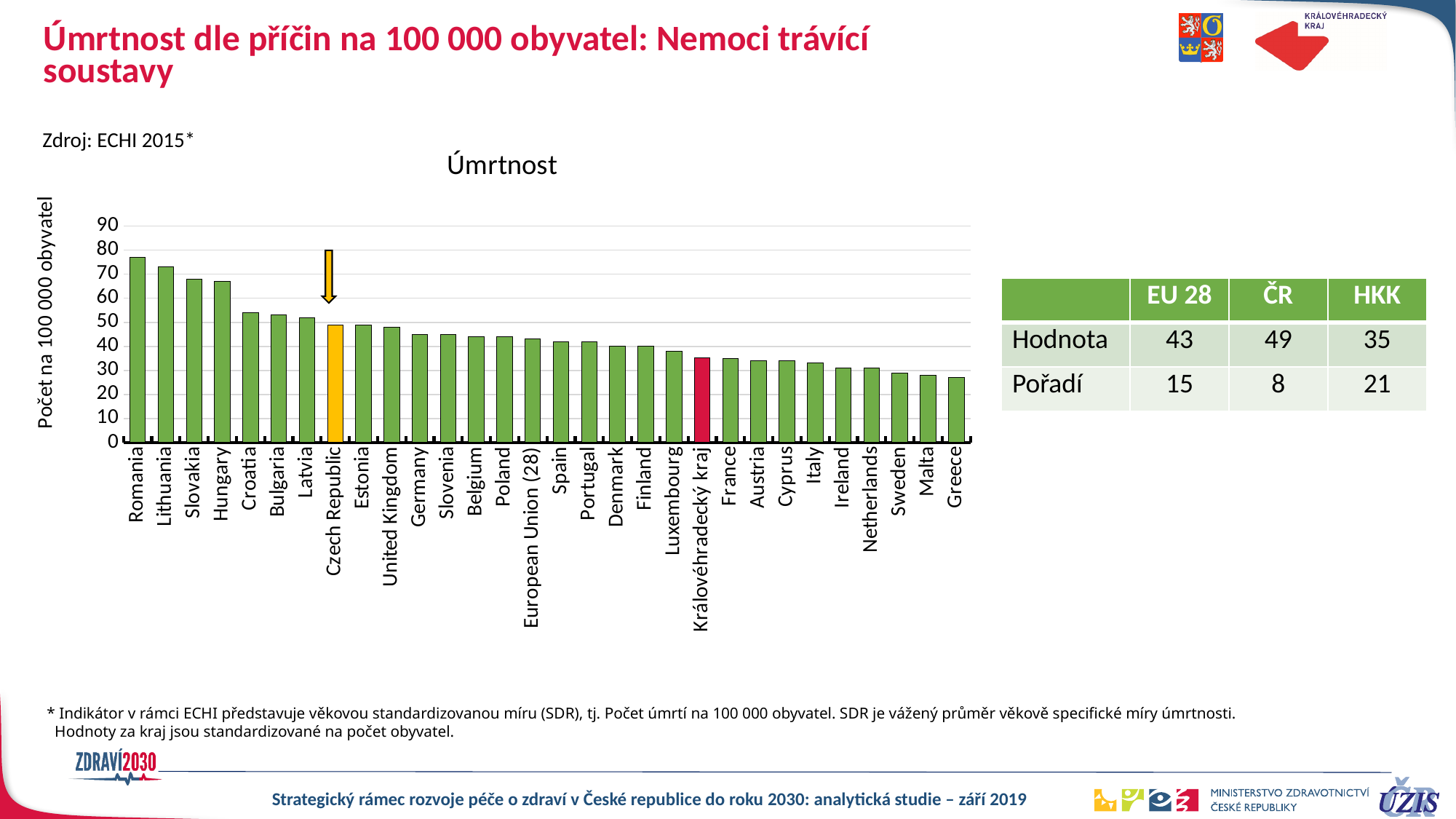
What is the title of the chart? Úmrtnost What is the difference between the values for Czech Republic and European Union (28)? 6 What is the value for European Union (28) according to the table? 43 Do the values rise or fall moving from left to right along the x axis? fall Is the value for Romania greater or less than 70? greater What is the value for Czech Republic (ČR) according to the table? 49 How many categories (bars) are plotted in the chart? 30 Which is larger, the value for Czech Republic or the value for Královéhradecký kraj? Czech Republic What is the value for Královéhradecký kraj (HKK) according to the table? 35 Which country has the highest mortality value in the chart? Romania Is the value for Luxembourg greater or less than 40? less What type of chart is shown on the slide? bar chart